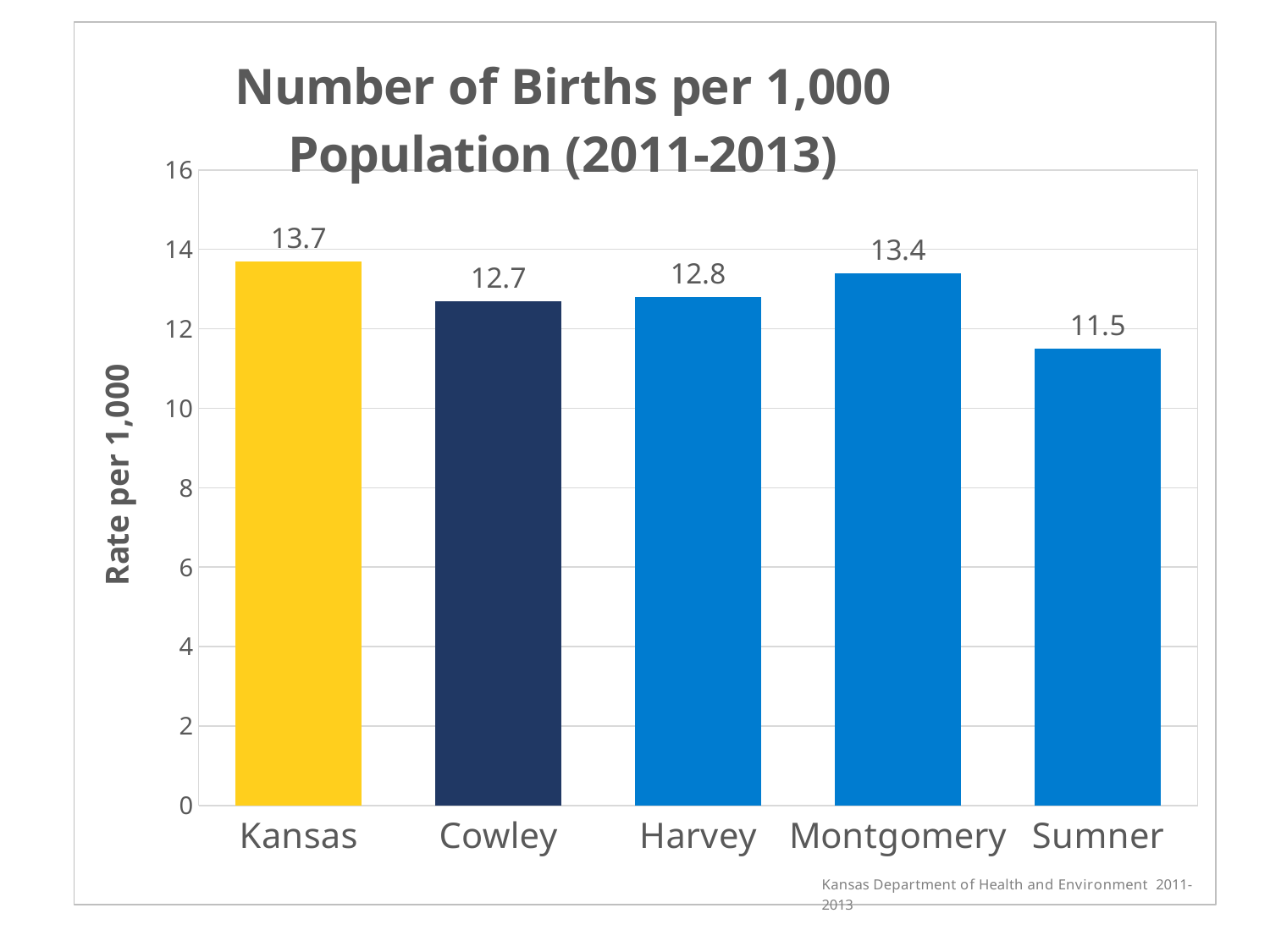
What is the value shown for Sumner? 11.5 What is the number of births per 1,000 population for Kansas? 13.7 What is the label of the vertical axis? Rate per 1,000 Which category has the lowest birth rate? Sumner What is the value shown for Montgomery? 13.4 Which category has the highest birth rate? Kansas How many categories are shown on the x axis? 5 What is the difference between the values for Kansas and Sumner? 2.2 Which is larger, the value for Montgomery or the value for Harvey? Montgomery What kind of chart is shown on the slide? bar chart What is the difference between the values for Montgomery and Cowley? 0.7 Is the value for Cowley greater or less than 12? greater